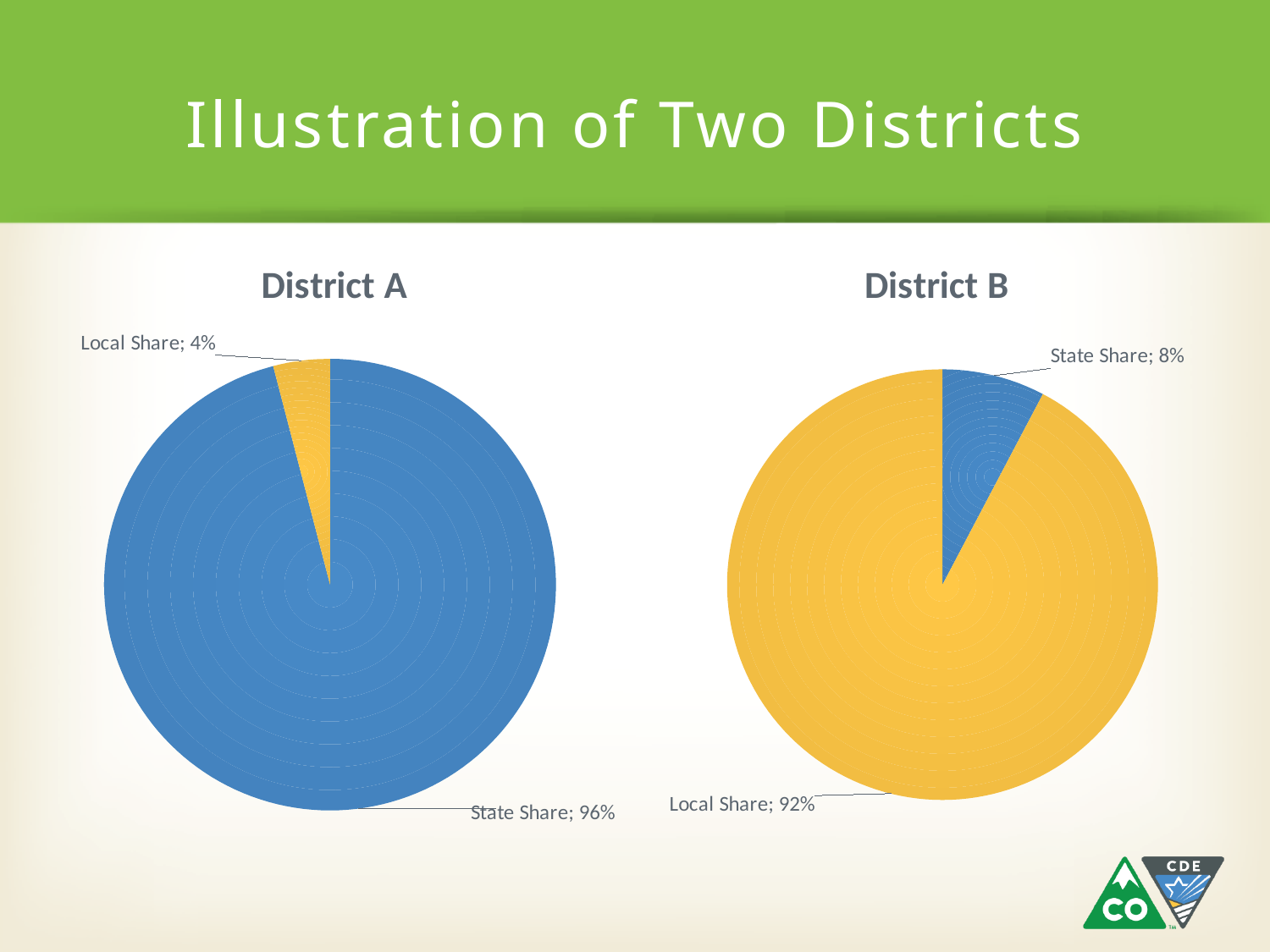
In the District B chart, what is the difference between the Local Share and the State Share? 84% In the District A chart, what is the Local Share? 4% In the District B chart, what is the Local Share? 92% What type of chart is used for District B? Pie chart In the District A chart, what is the difference between the State Share and the Local Share? 92% In the District B chart, which slice is the smallest? State Share In the District A chart, which slice is the largest? State Share In the District B chart, what is the State Share? 8% Which is larger: the State Share in District A or the Local Share in District B? State Share in District A How many slices does the District A chart have? 2 What is the title of the slide containing the two charts? Illustration of Two Districts In the District A chart, what is the State Share? 96%